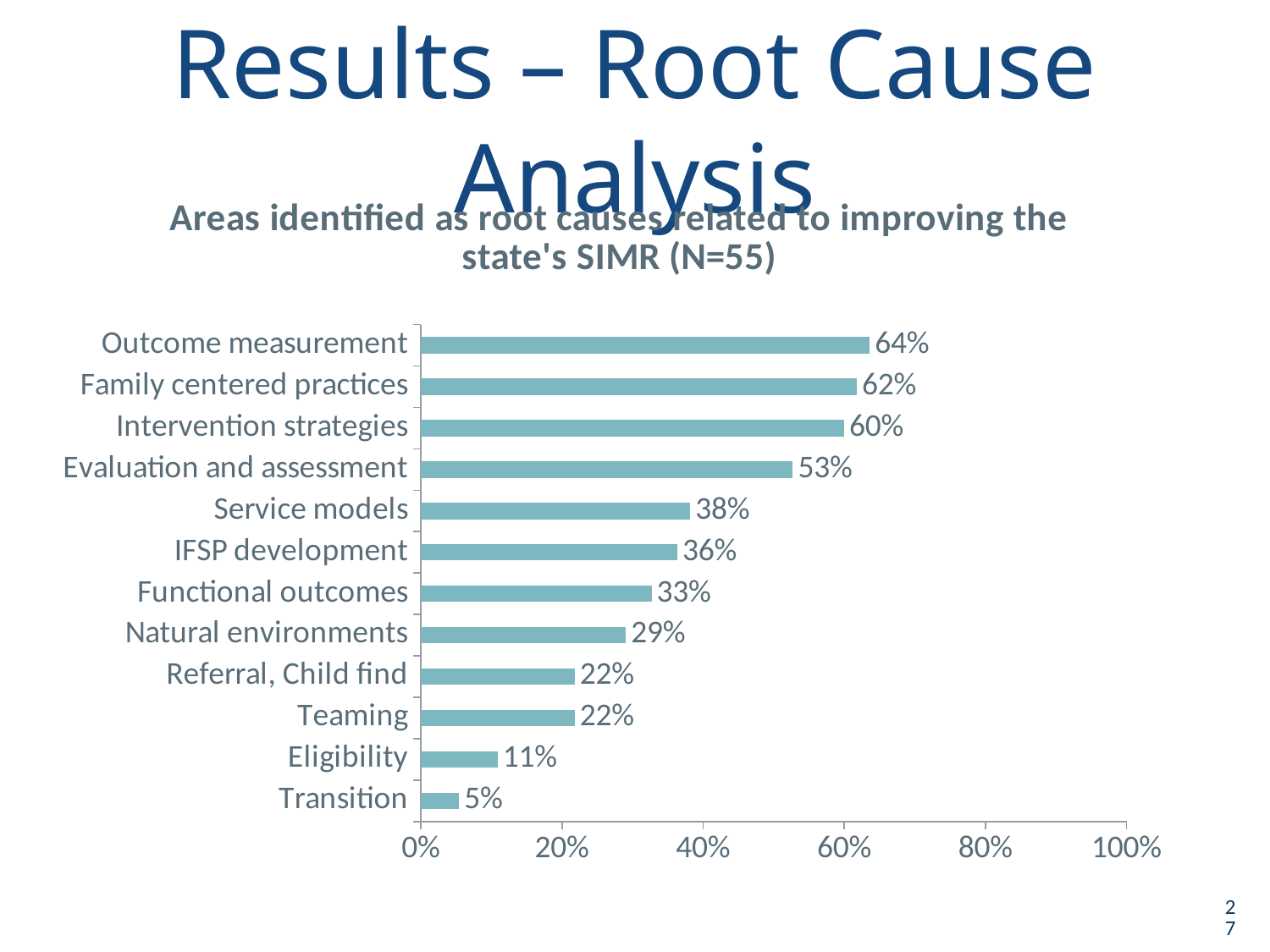
Is the value for Intervention strategies greater or less than 40%? greater Which area has the lowest percentage? Transition Which area has the highest percentage? Outcome measurement What is the N value given in the chart title? 55 What is the value for Natural environments? 29% How many areas are listed in the chart? 12 What percentage is shown for Outcome measurement? 64% What percentage is shown for Eligibility? 11% Which is larger, the value for IFSP development or the value for Functional outcomes? IFSP development What kind of chart is shown on the slide? Bar chart What is the difference between the values for Outcome measurement and Transition? 59% What is the difference between Evaluation and assessment and Service models? 15%